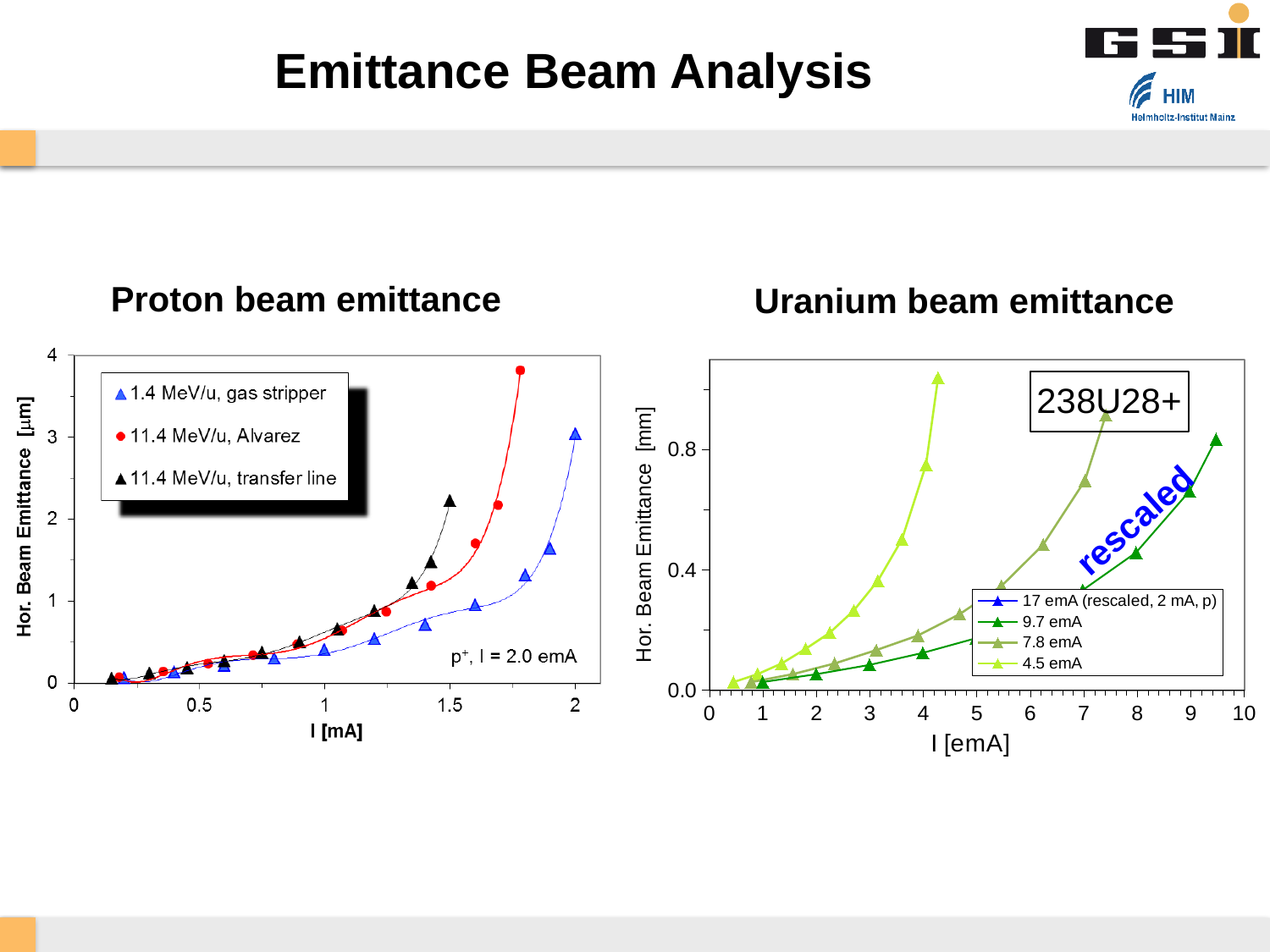
In the Uranium beam emittance chart, which series reaches the highest emittance? 4.5 emA Which series in the Proton beam emittance chart is plotted with red circles? 11.4 MeV/u, Alvarez In the Uranium beam emittance chart, is the highest value of the 4.5 emA series greater or less than 0.8? greater How many series does the legend of the Uranium beam emittance chart list? 4 How many series does the legend of the Proton beam emittance chart list? 3 In the Proton beam emittance chart, does the horizontal beam emittance rise or fall as the current I increases? rise In the Uranium beam emittance chart, does the horizontal beam emittance rise or fall as the current I increases? rise What is the x-axis label of the Uranium beam emittance chart? I [emA] In the Proton beam emittance chart, is the highest value of the 11.4 MeV/u, Alvarez series greater or less than 3? greater What kind of chart is the Proton beam emittance chart? line chart In the Proton beam emittance chart, is the highest value of the 11.4 MeV/u, transfer line series greater or less than 3? less